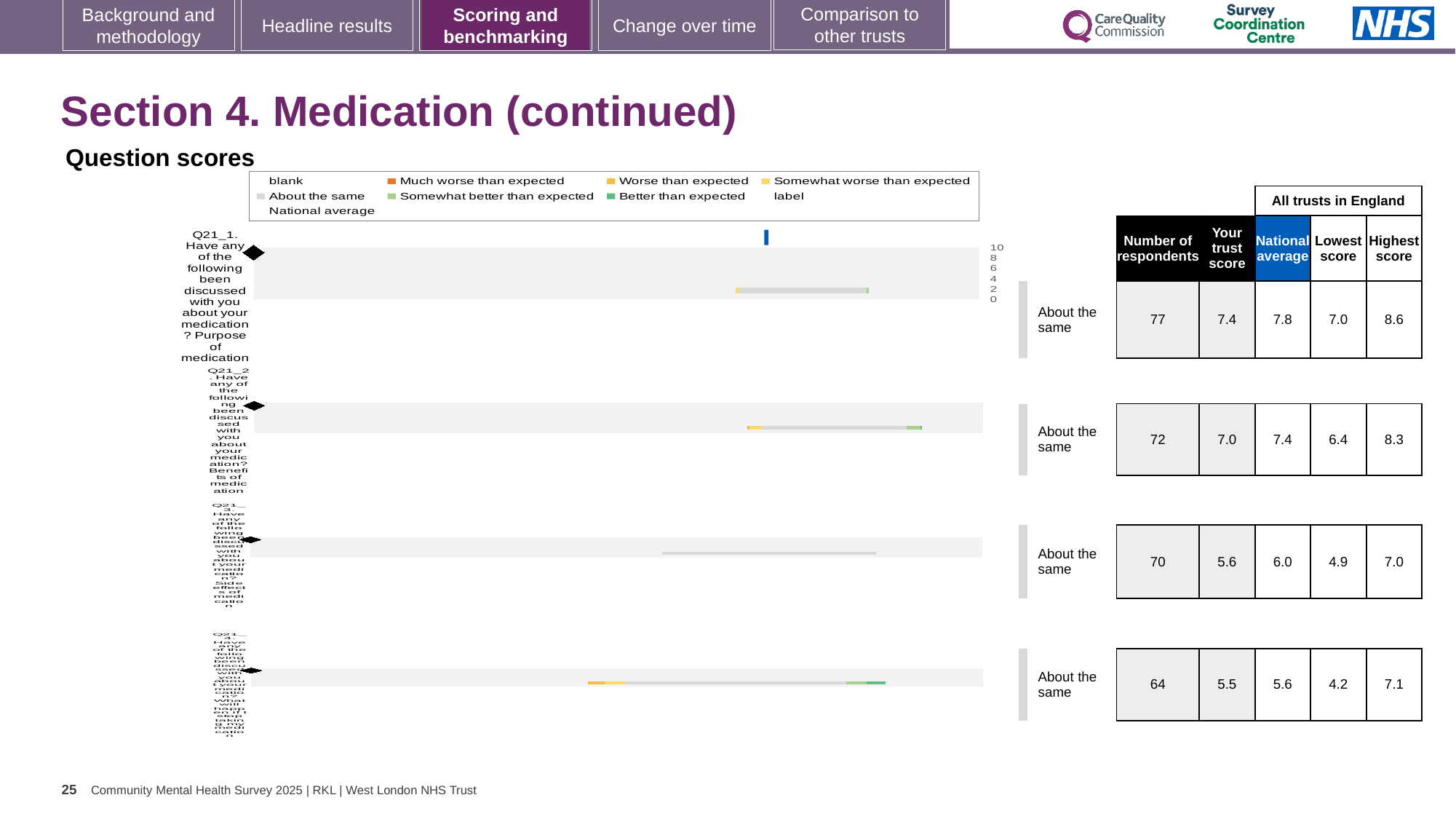
What is the highest score across all trusts in England for Q21_4? 7.1 What is the national average for Q21_2 (Benefits of medication)? 7.4 Which question has the highest number of respondents? Q21_1 How many entries does the chart legend list? 9 For Q21_2, which is larger: the trust score or the national average? National average What is the 'Your trust score' for Q21_1 (Purpose of medication)? 7.4 How many questions (rows) are plotted in the chart? 4 What is the difference between the national average and the trust score for Q21_1? 0.4 How many respondents answered Q21_3 (Side effects of medication)? 70 What kind of chart is shown under 'Question scores'? bar chart What is the lowest score across all trusts in England for Q21_1? 7.0 Which question has the lowest 'Your trust score'? Q21_4